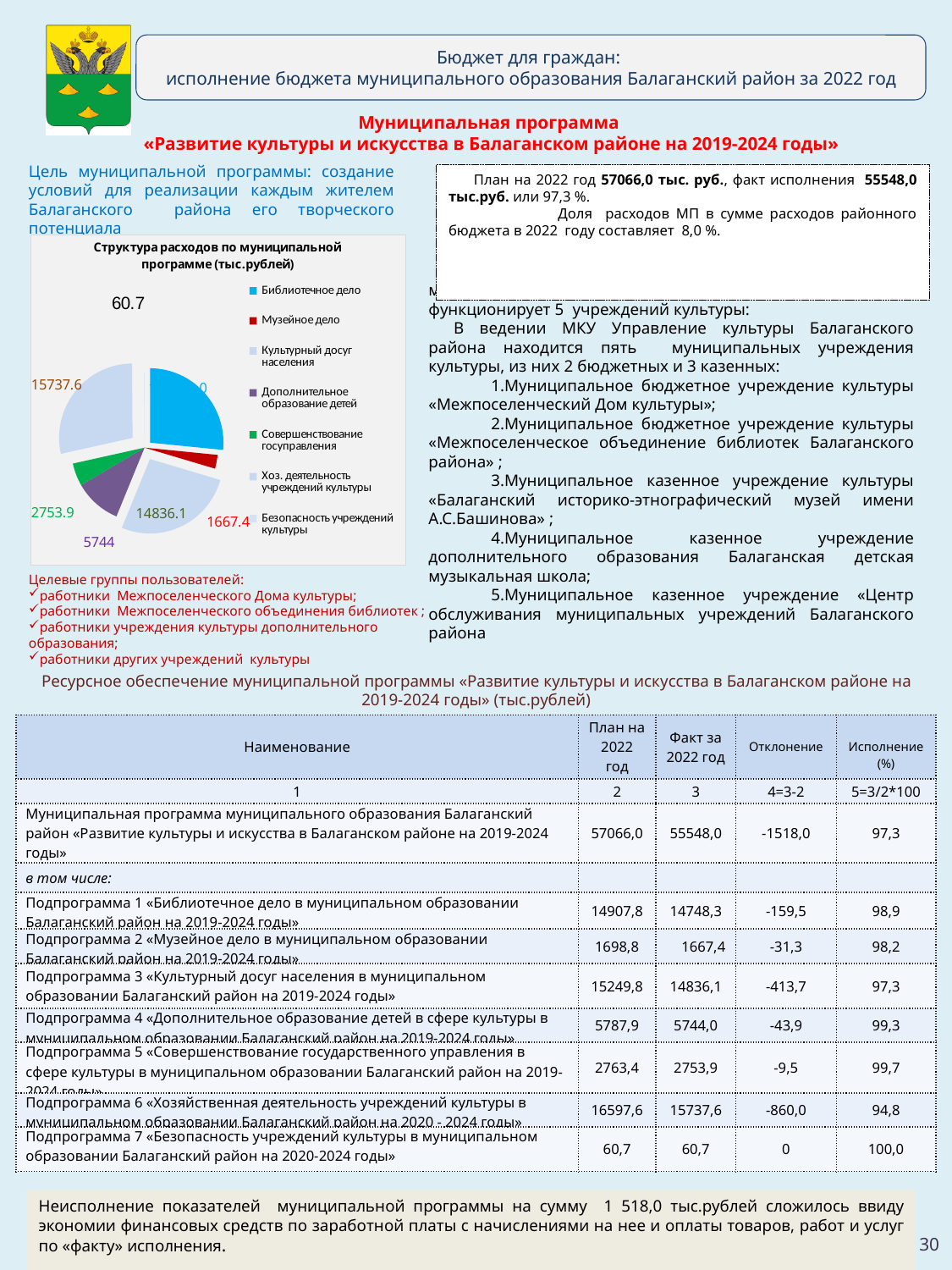
What is the difference between the values for Дополнительное образование детей and Совершенствование госуправления in the pie chart? 2990.1 What is the value shown for Дополнительное образование детей in the pie chart? 5744 What is the value shown for Совершенствование госуправления in the pie chart? 2753.9 What is the title of the chart on the slide? Структура расходов по муниципальной программе (тыс.рублей) In the pie chart, which is larger: Хоз. деятельность учреждений культуры or Культурный досуг населения? Хоз. деятельность учреждений культуры What is the value shown for Музейное дело in the pie chart? 1667.4 What is the value shown for Безопасность учреждений культуры in the pie chart? 60.7 What is the value shown for Хоз. деятельность учреждений культуры in the pie chart? 15737.6 Which category has the smallest slice in the pie chart? Безопасность учреждений культуры How many categories does the legend of the pie chart list? 7 What is the value shown for Культурный досуг населения in the pie chart? 14836.1 What kind of chart is shown on the slide? pie chart